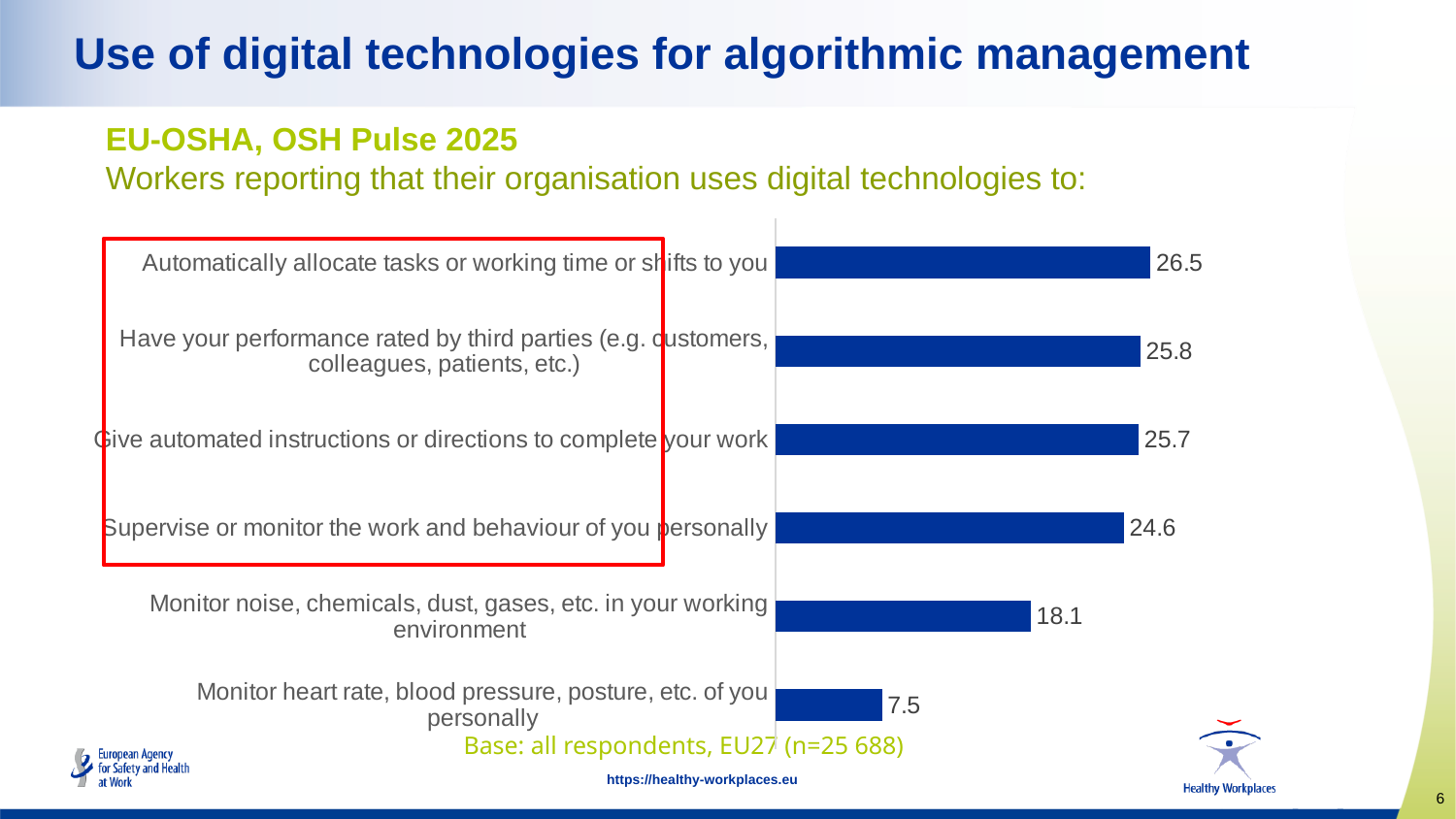
Which category has the highest value in the chart? Automatically allocate tasks or working time or shifts to you Which is larger: the value for 'Monitor noise, chemicals, dust, gases, etc. in your working environment' or the value for 'Monitor heart rate, blood pressure, posture, etc. of you personally'? Monitor noise, chemicals, dust, gases, etc. in your working environment What is the base stated below the chart? All respondents, EU27 (n=25 688) How many categories are shown in the chart? 6 What kind of chart is shown on the slide? Bar chart What percentage of workers report that their organisation uses digital technologies to automatically allocate tasks or working time or shifts to them? 26.5 What is the value for 'Have your performance rated by third parties (e.g. customers, colleagues, patients, etc.)'? 25.8 What is the value for 'Supervise or monitor the work and behaviour of you personally'? 24.6 What is the difference between the values for 'Supervise or monitor the work and behaviour of you personally' and 'Monitor noise, chemicals, dust, gases, etc. in your working environment'? 6.5 What is the difference between the values for 'Automatically allocate tasks or working time or shifts to you' and 'Monitor heart rate, blood pressure, posture, etc. of you personally'? 19.0 What is the value for 'Monitor heart rate, blood pressure, posture, etc. of you personally'? 7.5 Which category has the lowest value in the chart? Monitor heart rate, blood pressure, posture, etc. of you personally